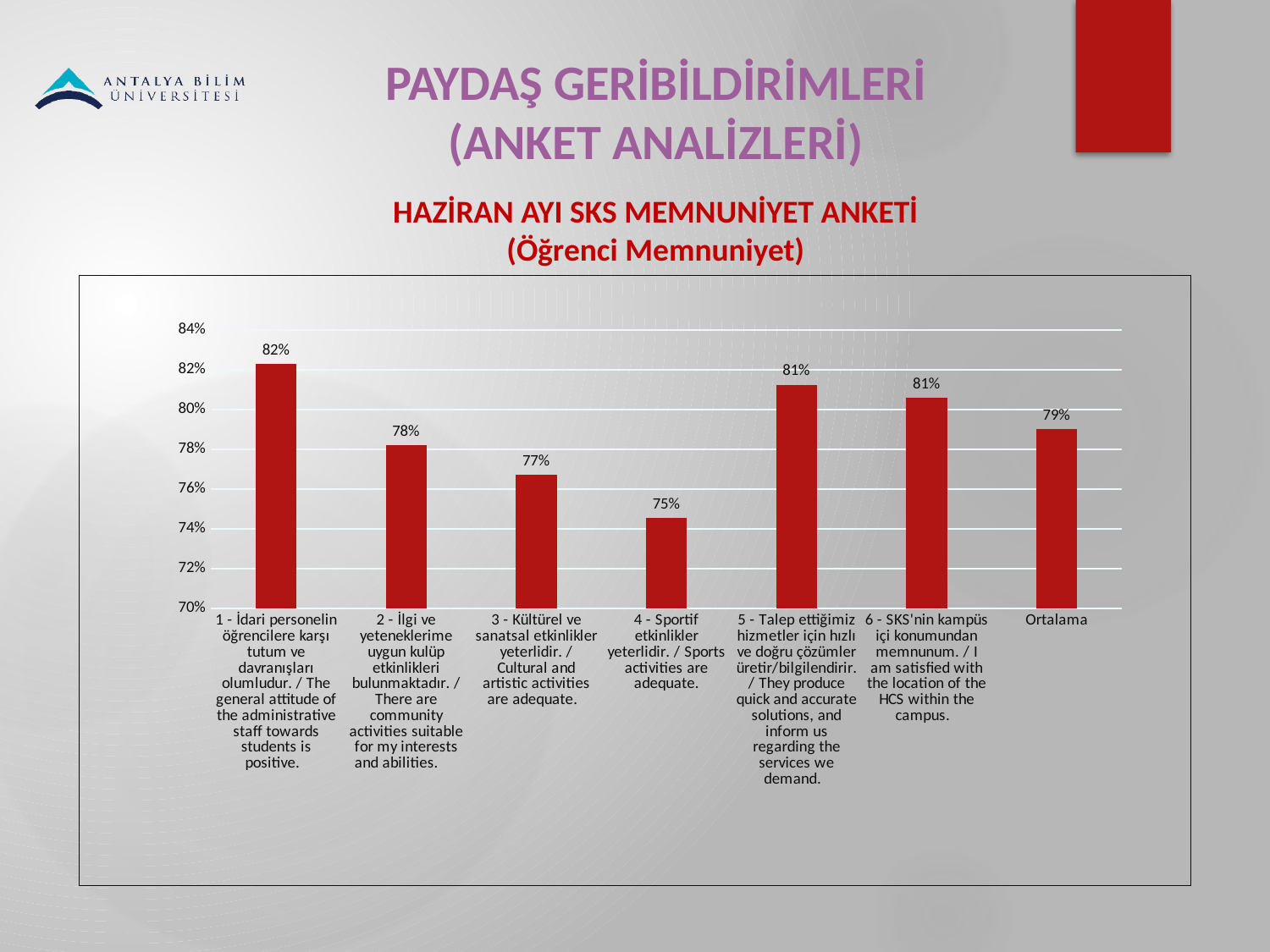
Is the value for category 2 greater or less than 80%? less What is the title of the survey shown above the chart? HAZİRAN AYI SKS MEMNUNİYET ANKETİ (Öğrenci Memnuniyet) Which is larger, the value for category 2 or the value for category 5? Category 5 What is the value for category 3 (Kültürel ve sanatsal etkinlikler yeterlidir)? 77% What is the difference between the value for category 1 and the value for category 4? 7% How many bars are shown in the chart? 7 What is the value for Ortalama? 79% What is the value for category 4 (Sportif etkinlikler yeterlidir)? 75% What kind of chart is shown on the slide? Bar chart Which category has the lowest value? 4 - Sportif etkinlikler yeterlidir. What is the value for category 1 (İdari personelin öğrencilere karşı tutum ve davranışları olumludur)? 82% Which category has the highest value? 1 - İdari personelin öğrencilere karşı tutum ve davranışları olumludur.